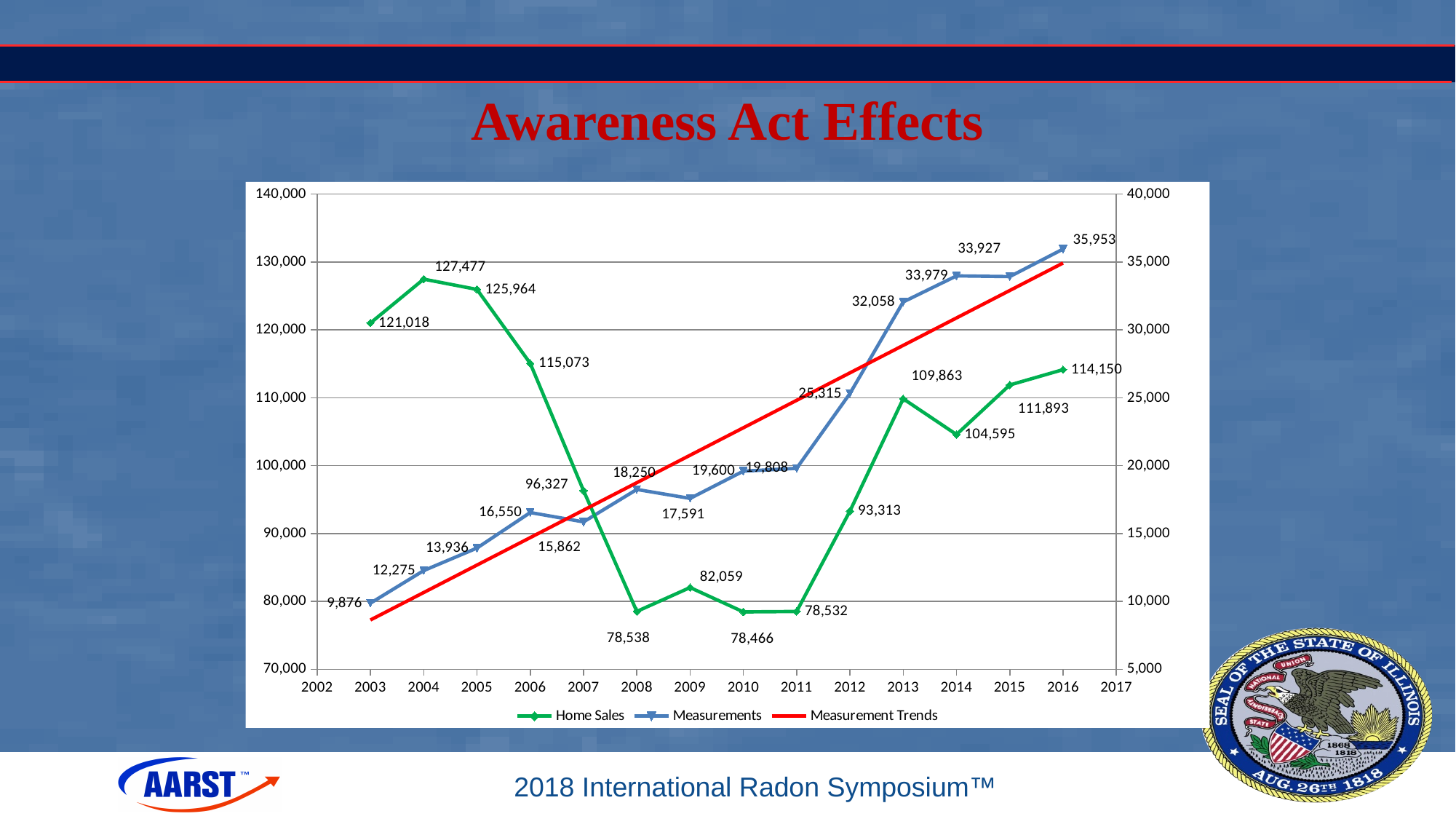
Which year has the larger Home Sales value, 2013 or 2014? 2013 What is the Home Sales value for 2004? 127,477 What is the difference between the Measurements values for 2016 and 2003? 26,077 How many series does the legend list? 3 What is the Measurements value for 2012? 25,315 What kind of chart is shown on the slide? Line chart Does the Measurements series generally rise or fall from 2003 to 2016? Rise What is the Home Sales value for 2016? 114,150 In which year is the Home Sales series lowest? 2010 In which year is the Measurements series highest? 2016 How many years have data points plotted for the Home Sales series? 14 What is the difference between the Home Sales values for 2004 and 2008? 48,939